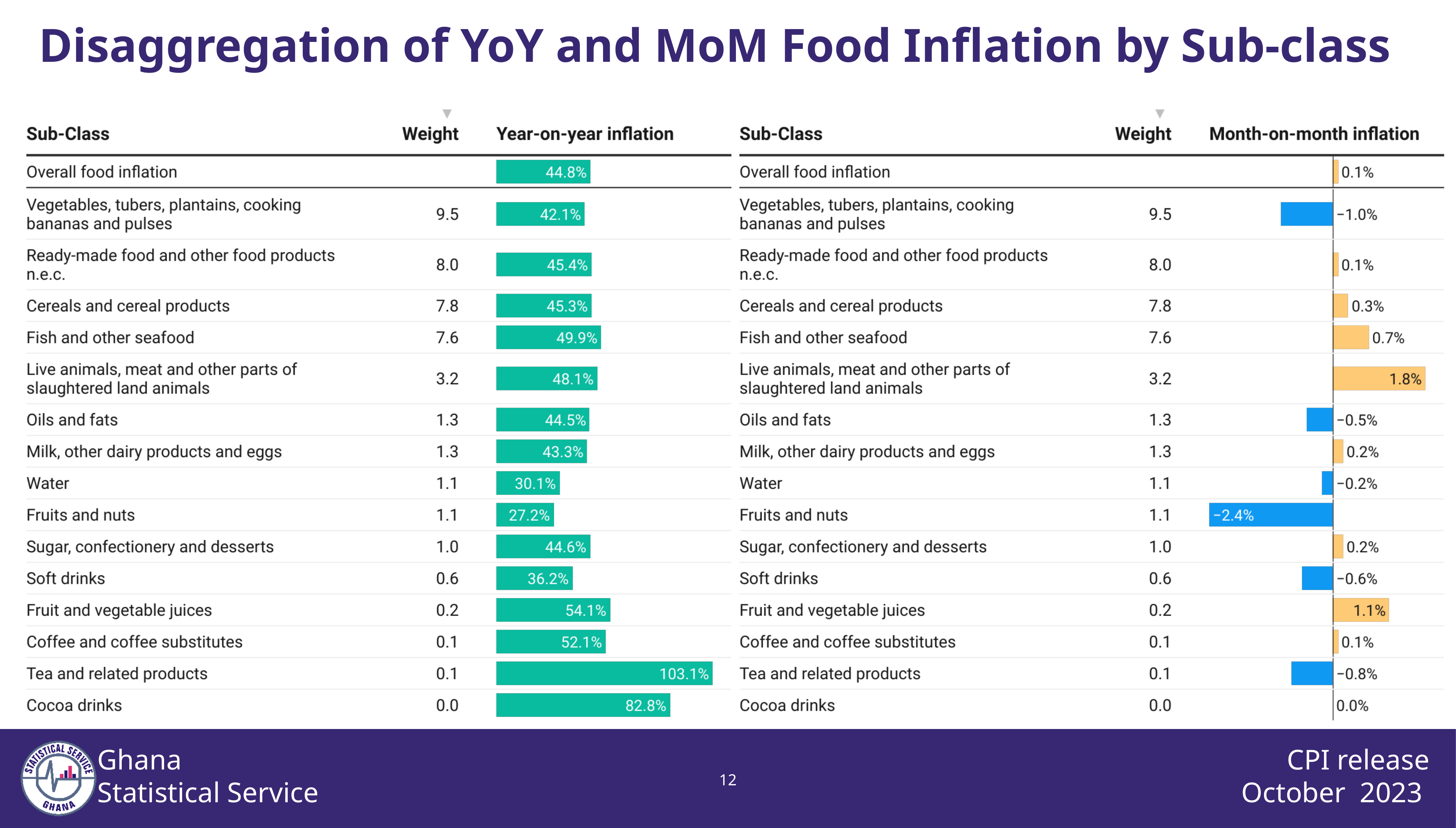
In the Month-on-month inflation chart, what is the value for Live animals, meat and other parts of slaughtered land animals? 1.8% In the Year-on-year inflation chart, which sub-class has the lowest inflation? Fruits and nuts In the Year-on-year inflation chart, what is the difference between Tea and related products and Cocoa drinks? 20.3 percentage points In the Year-on-year inflation chart, what is the value for Fish and other seafood? 49.9% In the Year-on-year inflation chart, which sub-class has the highest inflation? Tea and related products In the Month-on-month inflation chart, which sub-class has the highest inflation? Live animals, meat and other parts of slaughtered land animals What kind of chart is used to show Year-on-year inflation on this slide? Bar chart In the Month-on-month inflation chart, which sub-class has the lowest inflation? Fruits and nuts In the Month-on-month inflation chart, what is the value for Fruits and nuts? −2.4% In the Year-on-year inflation chart, what is the value for Tea and related products? 103.1% In the Year-on-year inflation chart, which is higher: Fruit and vegetable juices or Coffee and coffee substitutes? Fruit and vegetable juices In the Month-on-month inflation chart, what is the value for Overall food inflation? 0.1%